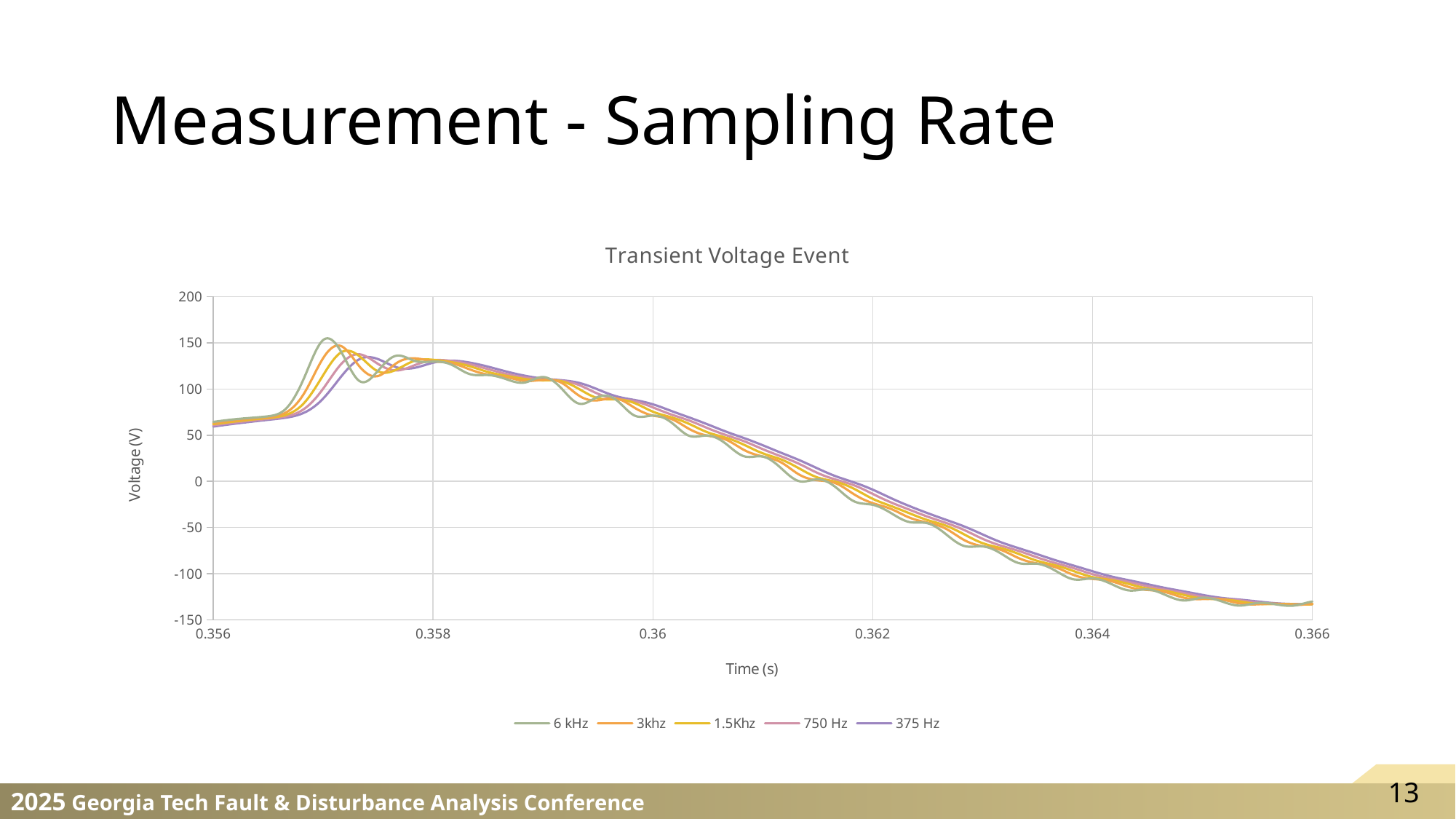
How many series does the legend of the Transient Voltage Event chart list? 5 Do the voltage values rise or fall along the time axis from 0.358 s to 0.366 s? fall Which series reaches the highest peak voltage in the Transient Voltage Event chart? 6 kHz Which series has the larger peak voltage, 6 kHz or 375 Hz? 6 kHz What is the title of the chart on the slide? Transient Voltage Event Is the voltage of the 6 kHz series at 0.356 s greater or less than 50? greater What kind of chart is shown on the slide? Line chart Is the peak voltage of the 375 Hz series greater or less than 150? less Is the voltage of the 6 kHz series at 0.366 s greater or less than -100? less What is the label of the vertical axis of the chart? Voltage (V) Which series has the lowest peak voltage during the transient near 0.357 s? 375 Hz